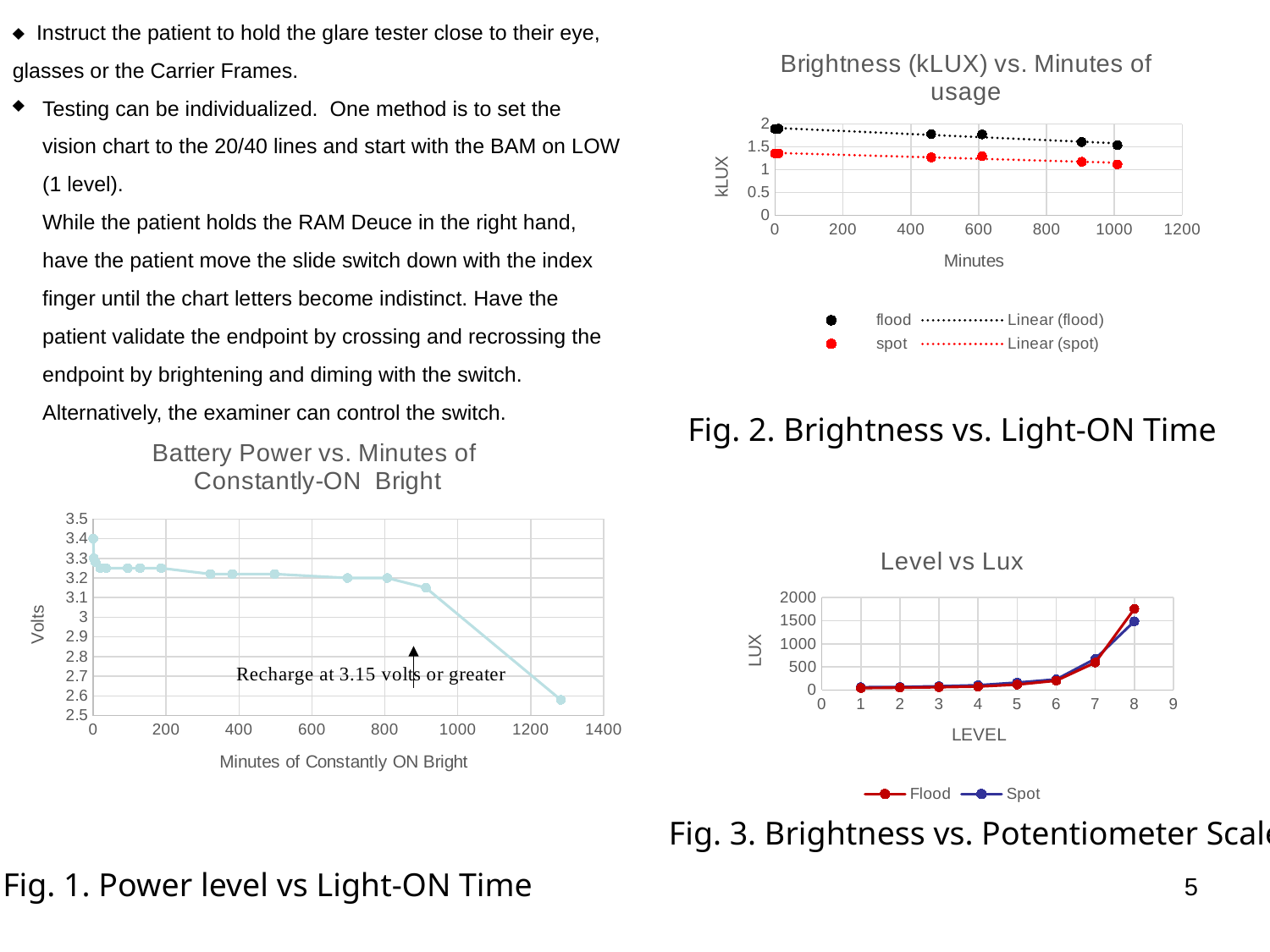
In the 'Level vs Lux' chart, at which level is the Flood value highest? 8 How many entries does the legend of the 'Brightness (kLUX) vs. Minutes of usage' chart list? 4 In the 'Level vs Lux' chart, is the Flood value at level 8 greater or less than 1500? greater What does the annotation on the 'Battery Power vs. Minutes of Constantly-ON Bright' chart say? Recharge at 3.15 volts or greater In the 'Battery Power vs. Minutes of Constantly-ON Bright' chart, is the voltage at 0 minutes greater or less than 3.3? greater What kind of chart is the 'Battery Power vs. Minutes of Constantly-ON Bright' chart? line chart In the 'Battery Power vs. Minutes of Constantly-ON Bright' chart, is the voltage at the last plotted point (around 1280 minutes) greater or less than 3? less How many series does the legend of the 'Level vs Lux' chart list? 2 In the 'Battery Power vs. Minutes of Constantly-ON Bright' chart, do the voltage values rise or fall as minutes increase? fall In the 'Brightness (kLUX) vs. Minutes of usage' chart, do the flood values rise or fall as minutes increase? fall In the 'Brightness (kLUX) vs. Minutes of usage' chart, which series has the higher value at 0 minutes, flood or spot? flood